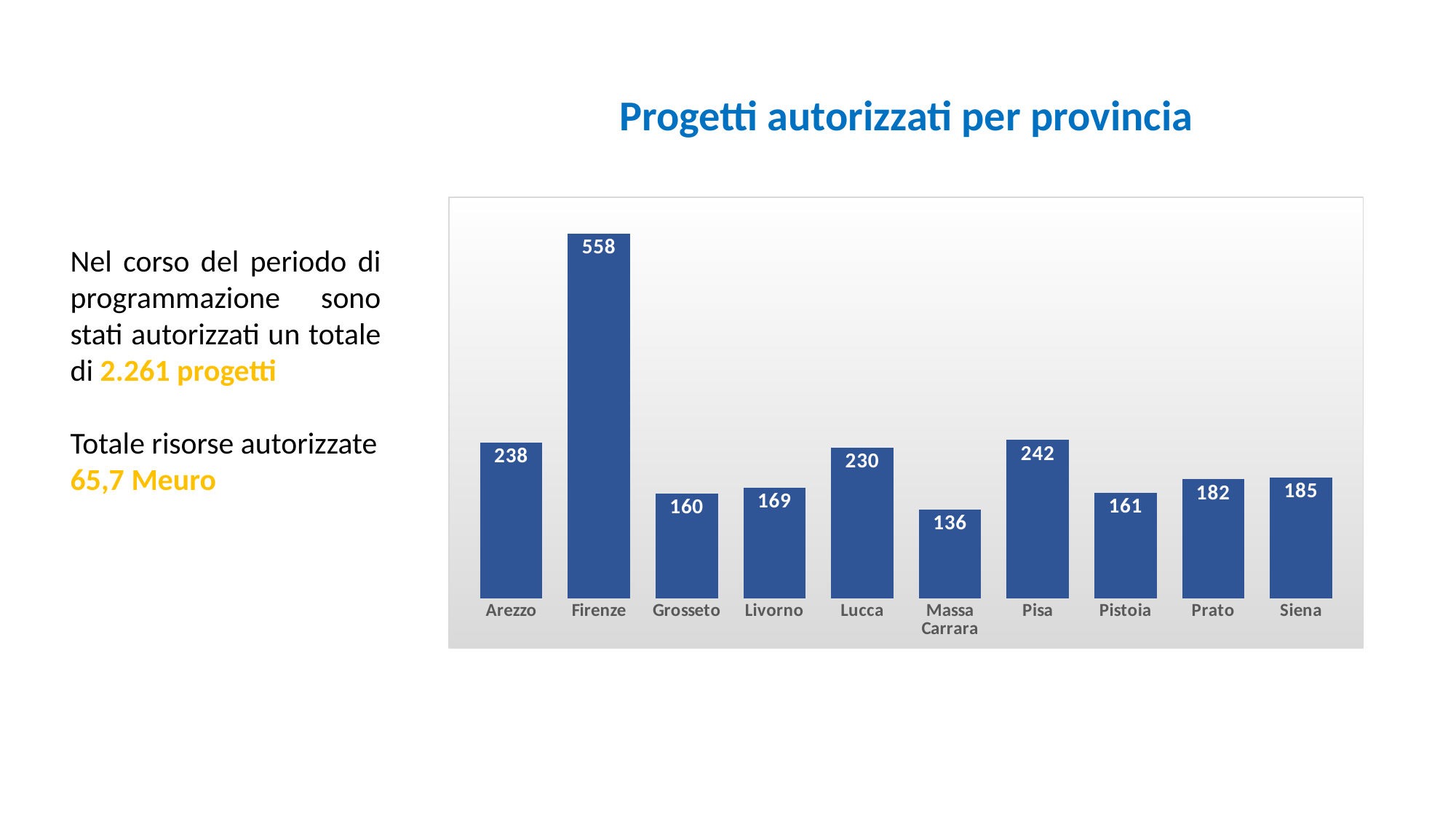
What is the value for Firenze? 558 What is the value for Massa Carrara? 136 How many provinces are shown in the chart? 10 What is the value for Siena? 185 Which province has the lowest number of authorized projects? Massa Carrara Which province has the highest number of authorized projects? Firenze What kind of chart is shown on the slide? Bar chart What is the title of the chart? Progetti autorizzati per provincia What is the value for Pisa? 242 Which is larger, the value for Livorno or the value for Grosseto? Livorno What is the difference between the values for Pisa and Lucca? 12 What is the difference between the values for Firenze and Arezzo? 320